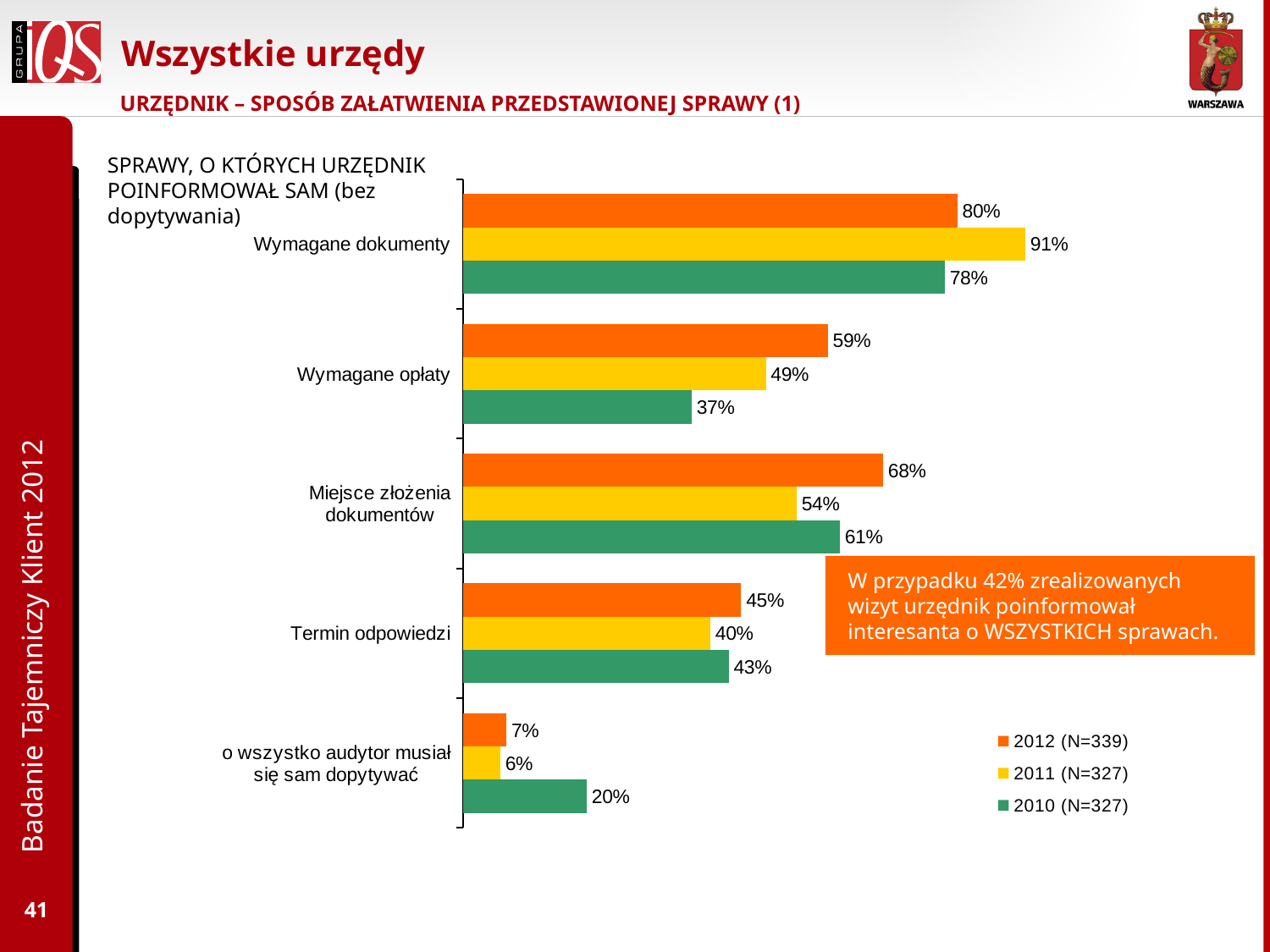
What is the value for Termin odpowiedzi in the 2011 (N=327) series? 40% Which is larger for Wymagane opłaty: the 2012 (N=339) value or the 2011 (N=327) value? 2012 (N=339) What kind of chart is shown on the slide? Bar chart How many categories are shown on the chart? 5 What is the value for Wymagane dokumenty in the 2012 (N=339) series? 80% Which category has the lowest value in the 2012 (N=339) series? o wszystko audytor musiał się sam dopytywać What is the difference between the 2012 and 2010 values for Miejsce złożenia dokumentów? 7 percentage points Which colour represents the 2011 (N=327) series in the legend? Yellow What is the value for Wymagane opłaty in the 2010 (N=327) series? 37% How many series does the legend list? 3 What is the value for o wszystko audytor musiał się sam dopytywać in the 2010 (N=327) series? 20% Which category has the highest value in the 2011 (N=327) series? Wymagane dokumenty